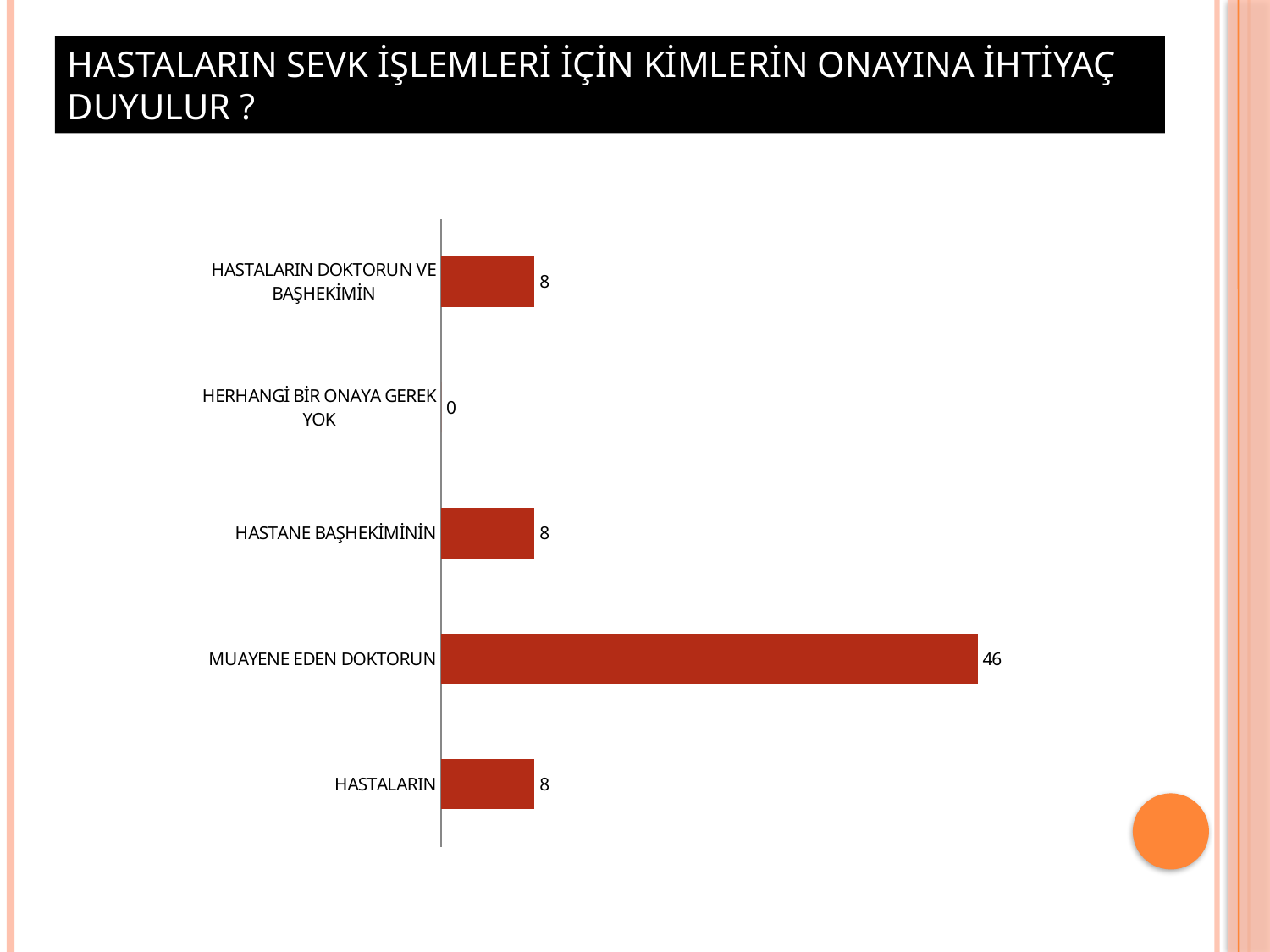
What is the total of all the values shown in the chart? 70 Which is larger, the value for MUAYENE EDEN DOKTORUN or the value for HASTANE BAŞHEKİMİNİN? MUAYENE EDEN DOKTORUN What is the value for HERHANGİ BİR ONAYA GEREK YOK? 0 What is the value for HASTALARIN DOKTORUN VE BAŞHEKİMİN? 8 Which category has the highest value? MUAYENE EDEN DOKTORUN What is the difference between the values for MUAYENE EDEN DOKTORUN and HASTALARIN? 38 What is the value for HASTANE BAŞHEKİMİNİN? 8 How many categories are shown in the chart? 5 What is the value for MUAYENE EDEN DOKTORUN? 46 Which category has the lowest value? HERHANGİ BİR ONAYA GEREK YOK What kind of chart is shown on the slide? Bar chart What is the title of the slide? HASTALARIN SEVK İŞLEMLERİ İÇİN KİMLERİN ONAYINA İHTİYAÇ DUYULUR ?